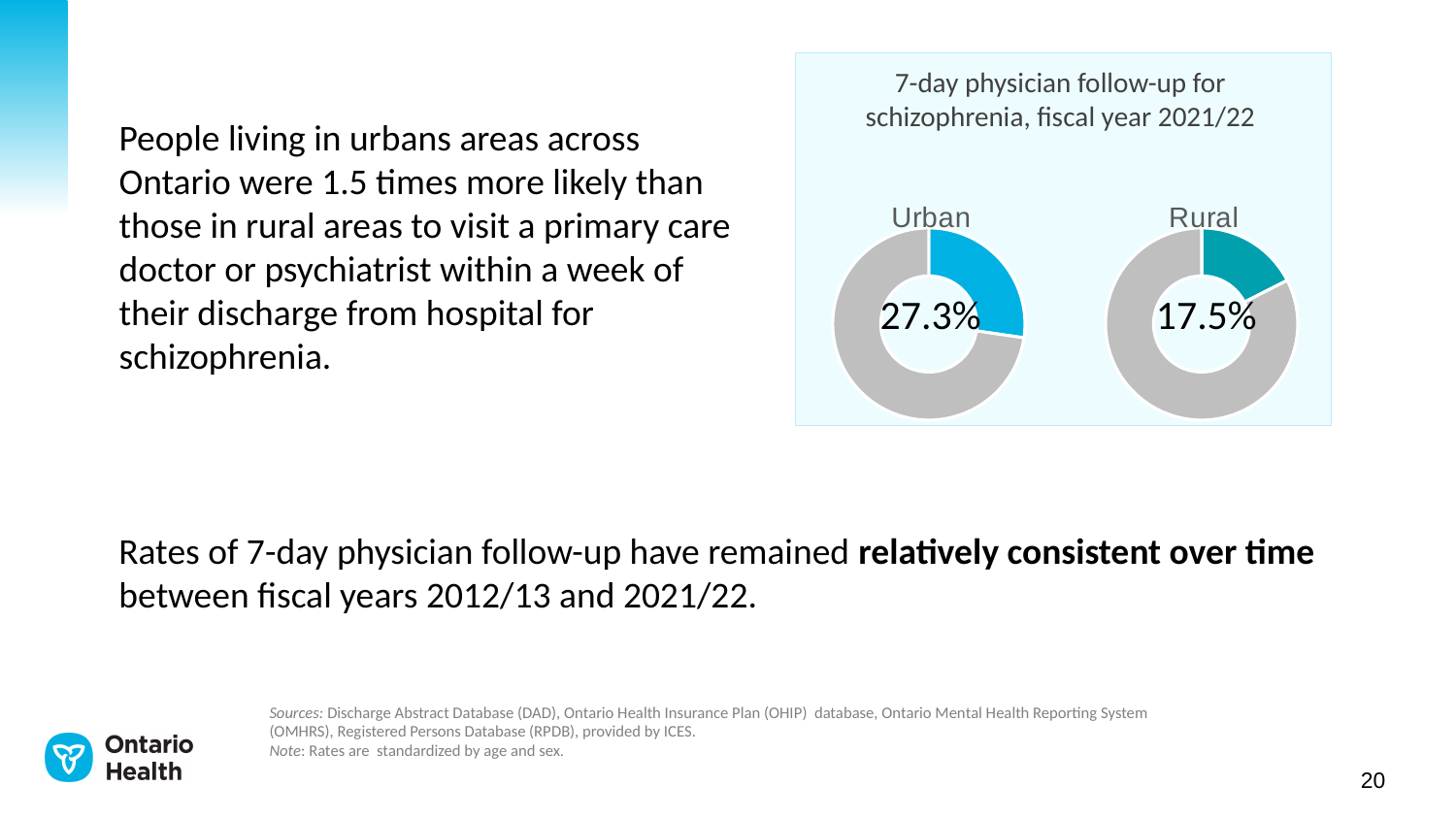
What is the difference in percentage points between the Urban and Rural 7-day physician follow-up rates? 9.8 percentage points Is the Urban 7-day follow-up rate larger or smaller than the Rural rate? larger What is the 7-day physician follow-up rate for schizophrenia shown for Urban areas? 27.3% Which fiscal year does the chart cover? 2021/22 Which area, Urban or Rural, has the lower 7-day physician follow-up rate? Rural What is the 7-day physician follow-up rate for schizophrenia shown for Rural areas? 17.5% How many donut charts are shown on the slide? 2 What type of chart is used to show the Urban and Rural follow-up rates? Donut (pie) chart What is the title of the chart on the slide? 7-day physician follow-up for schizophrenia, fiscal year 2021/22 Which area, Urban or Rural, has the higher 7-day physician follow-up rate? Urban Is the Urban 7-day follow-up rate greater or less than 25%? greater Is the Rural 7-day follow-up rate greater or less than 20%? less